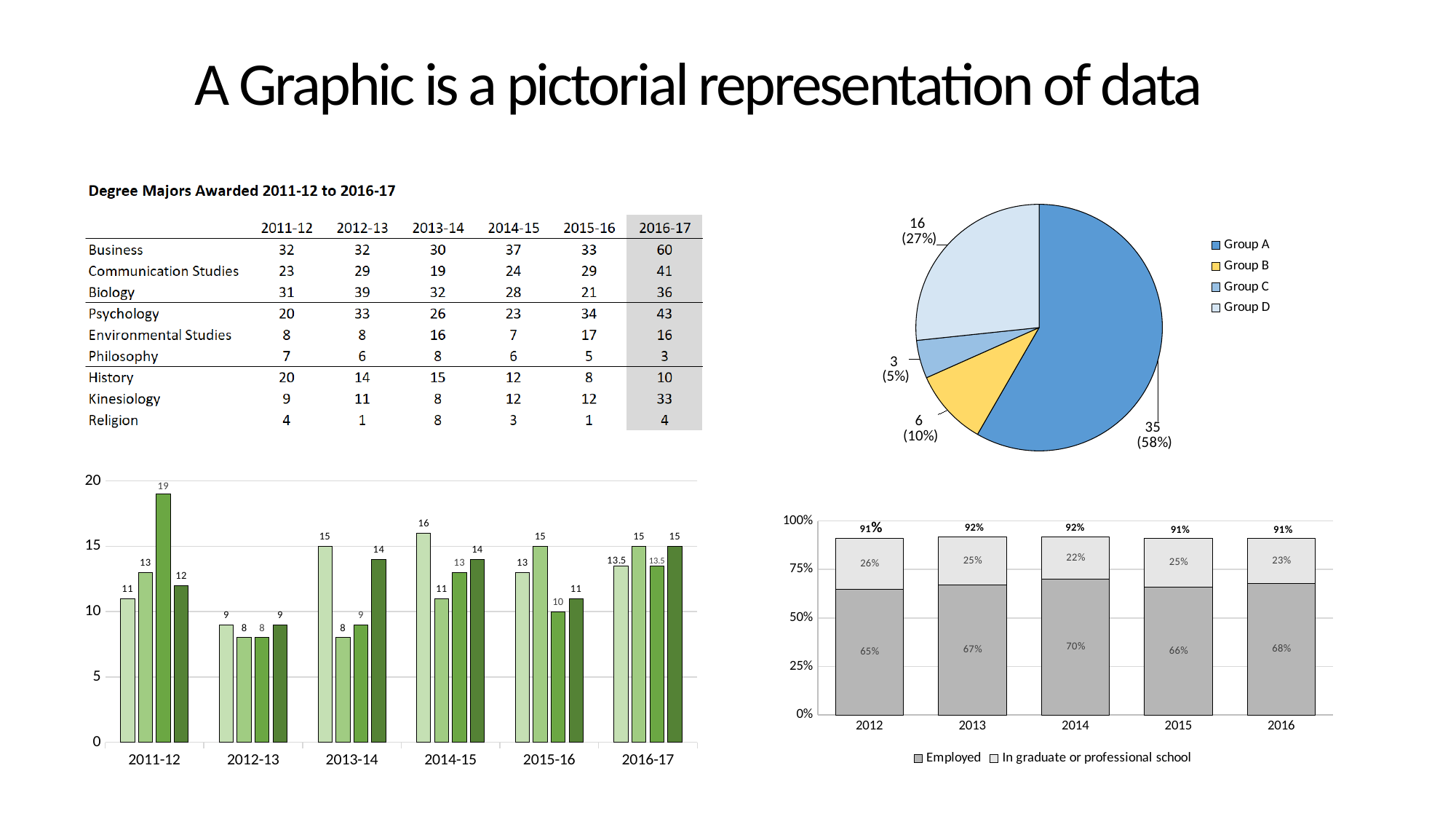
In the stacked bar chart at the bottom right, how many series does the legend list? 2 In the bar chart at the bottom left, what is the highest value shown in the 2011-12 group? 19 In the stacked bar chart at the bottom right, what is the Employed value for 2014? 70% In the stacked bar chart at the bottom right, is the Employed value for 2016 greater or less than 50%? greater In the stacked bar chart at the bottom right, what is the 'In graduate or professional school' value for 2012? 26% What kind of chart is shown at the bottom left of the slide? bar chart In the stacked bar chart at the bottom right, which year has the highest Employed value? 2014 In the pie chart, which group has the smallest slice? Group C In the pie chart, what share of the pie does Group A represent? 58% How many slices does the pie chart have? 4 In the pie chart, what is the value shown for Group D? 16 In the stacked bar chart at the bottom right, what is the total shown above the 2013 bar? 92%